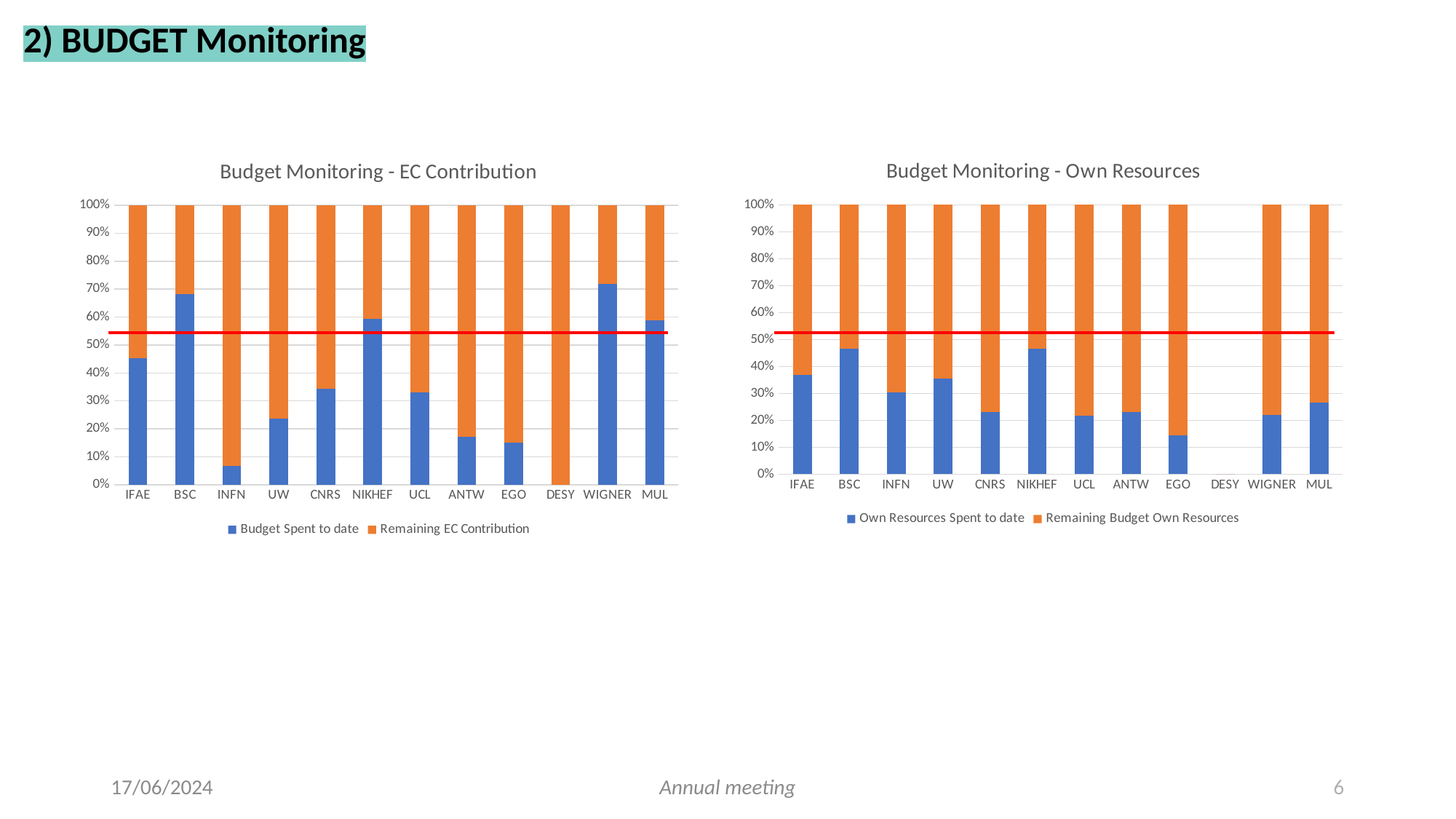
In the 'Budget Monitoring - EC Contribution' chart, how many categories are shown on the x axis? 12 In the 'Budget Monitoring - EC Contribution' chart, is the Budget Spent to date for BSC greater or less than 60%? greater What kind of chart is the 'Budget Monitoring - EC Contribution' chart? Stacked bar chart In the 'Budget Monitoring - EC Contribution' chart, is the Budget Spent to date for INFN greater or less than 10%? less In the 'Budget Monitoring - Own Resources' chart, what is the total height of the stacked bar for BSC? 100% How many series does the legend of the 'Budget Monitoring - Own Resources' chart list? 2 In the 'Budget Monitoring - EC Contribution' chart, which category shows no Budget Spent to date at all? DESY In the 'Budget Monitoring - EC Contribution' chart, which is larger, the Budget Spent to date for IFAE or for UW? IFAE What is the second legend entry in the 'Budget Monitoring - Own Resources' chart? Remaining Budget Own Resources In the 'Budget Monitoring - Own Resources' chart, which is larger, the Own Resources Spent to date for IFAE or for CNRS? IFAE In the 'Budget Monitoring - EC Contribution' chart, which category has the highest Budget Spent to date? WIGNER In the 'Budget Monitoring - Own Resources' chart, is the Own Resources Spent to date for EGO greater or less than 20%? less